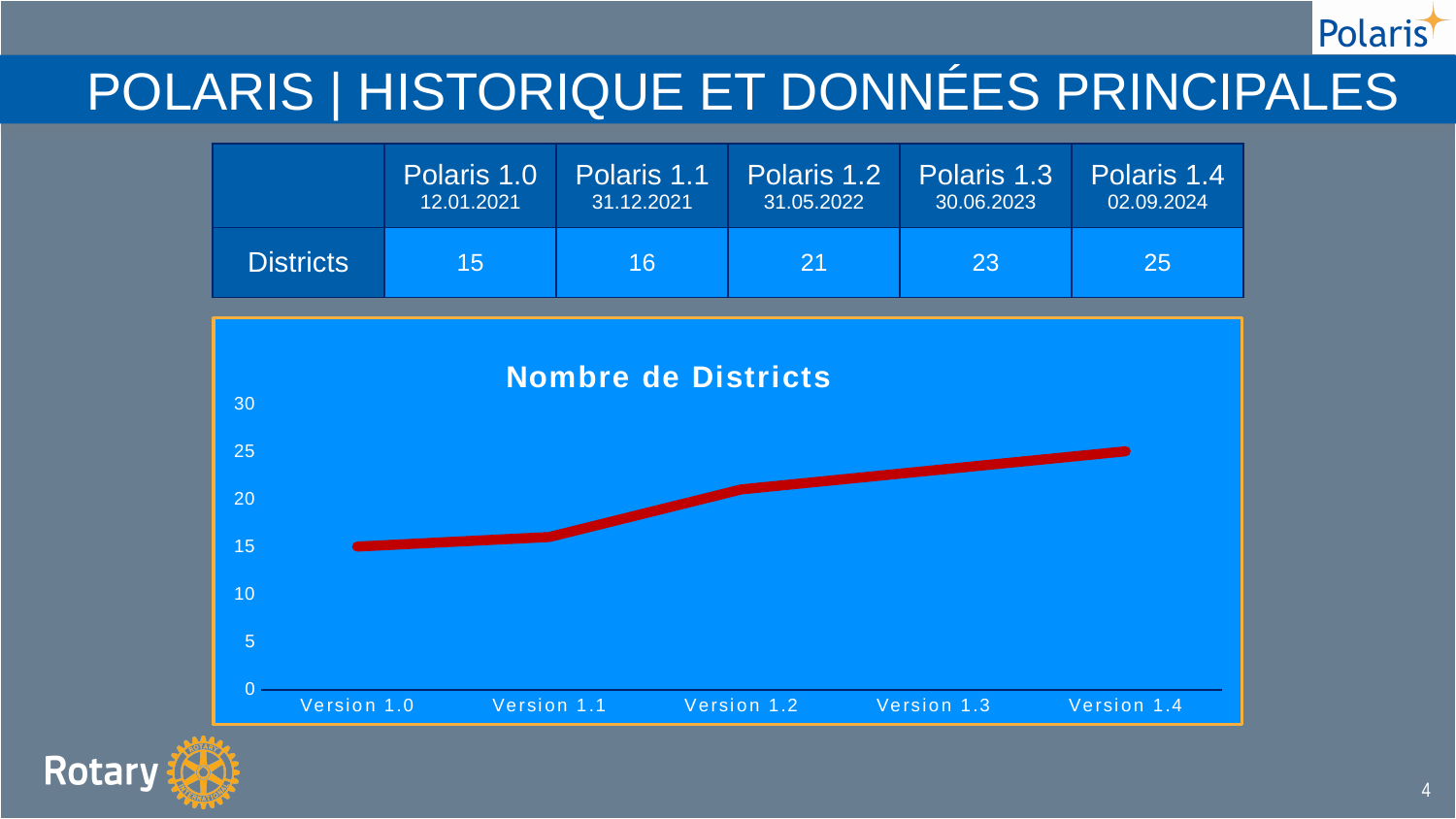
Which has more districts, Version 1.2 or Version 1.4? Version 1.4 What is the title of the chart? Nombre de Districts What is the number of districts for Version 1.0? 15 Is the value for Version 1.1 greater or less than 20? less What is the difference in the number of districts between Version 1.4 and Version 1.0? 10 Is the value for Version 1.3 greater or less than 20? greater What kind of chart is shown on the slide? line chart Which version has the lowest number of districts? Version 1.0 What is the number of districts for Version 1.4? 25 How many versions are plotted along the x axis of the chart? 5 Which version has the highest number of districts? Version 1.4 Does the number of districts rise or fall from Version 1.0 to Version 1.4? rise